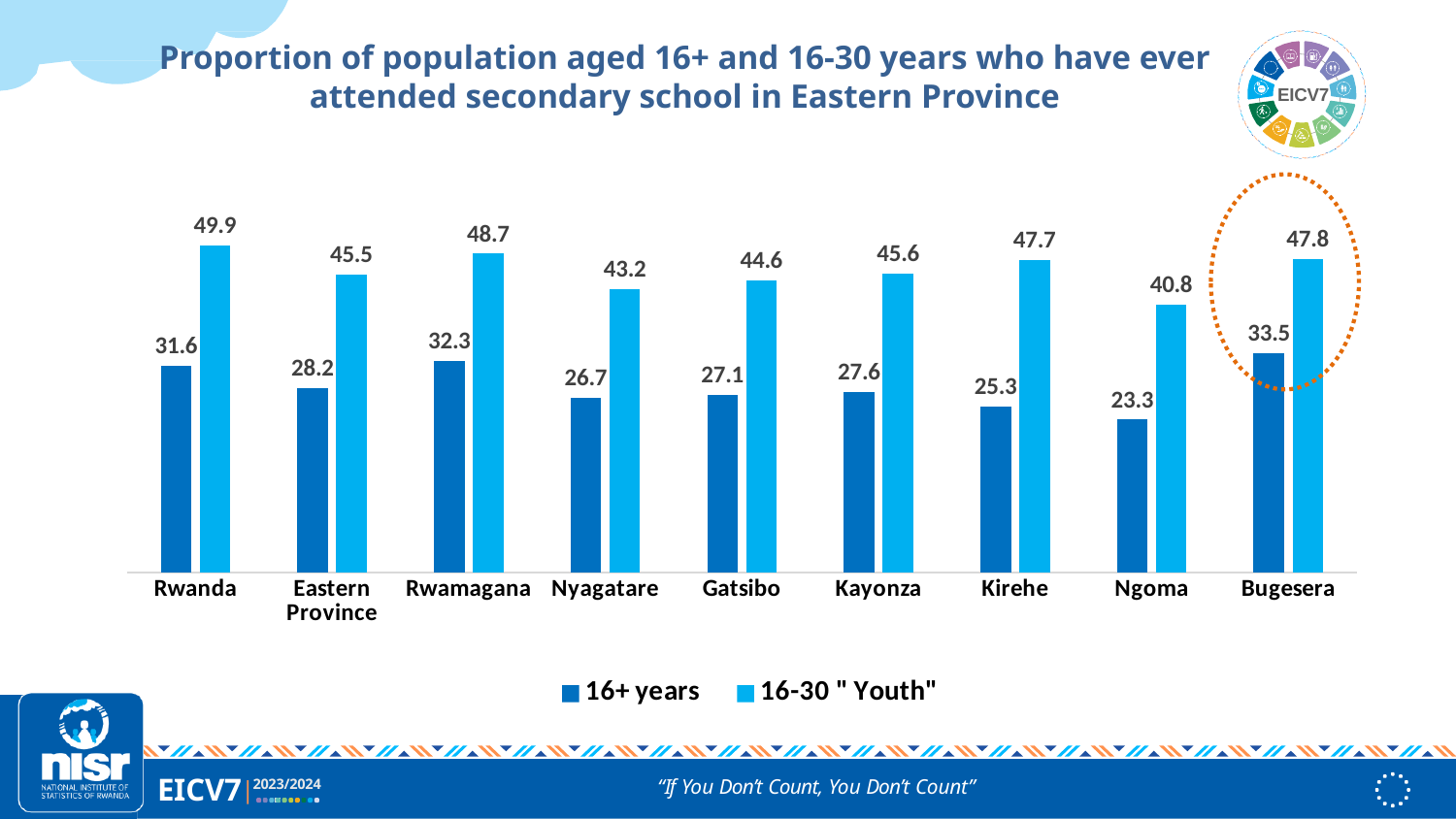
What is the difference between the 16-30 "Youth" value and the 16+ years value for Rwanda? 18.3 Which category has the lowest value in the 16+ years series? Ngoma How many series does the legend list? 2 What is the value for the 16+ years series for Rwanda? 31.6 What is the value for the 16+ years series for Eastern Province? 28.2 What is the difference between the 16-30 "Youth" value and the 16+ years value for Bugesera? 14.3 Which category has the highest value in the 16+ years series? Bugesera How many categories are shown on the x axis of the chart? 9 Which category has the highest value in the 16-30 "Youth" series? Rwanda What is the value for the 16-30 "Youth" series for Kirehe? 47.7 Which is larger, the 16-30 "Youth" value for Rwamagana or for Nyagatare? Rwamagana What kind of chart is shown on the slide? Bar chart